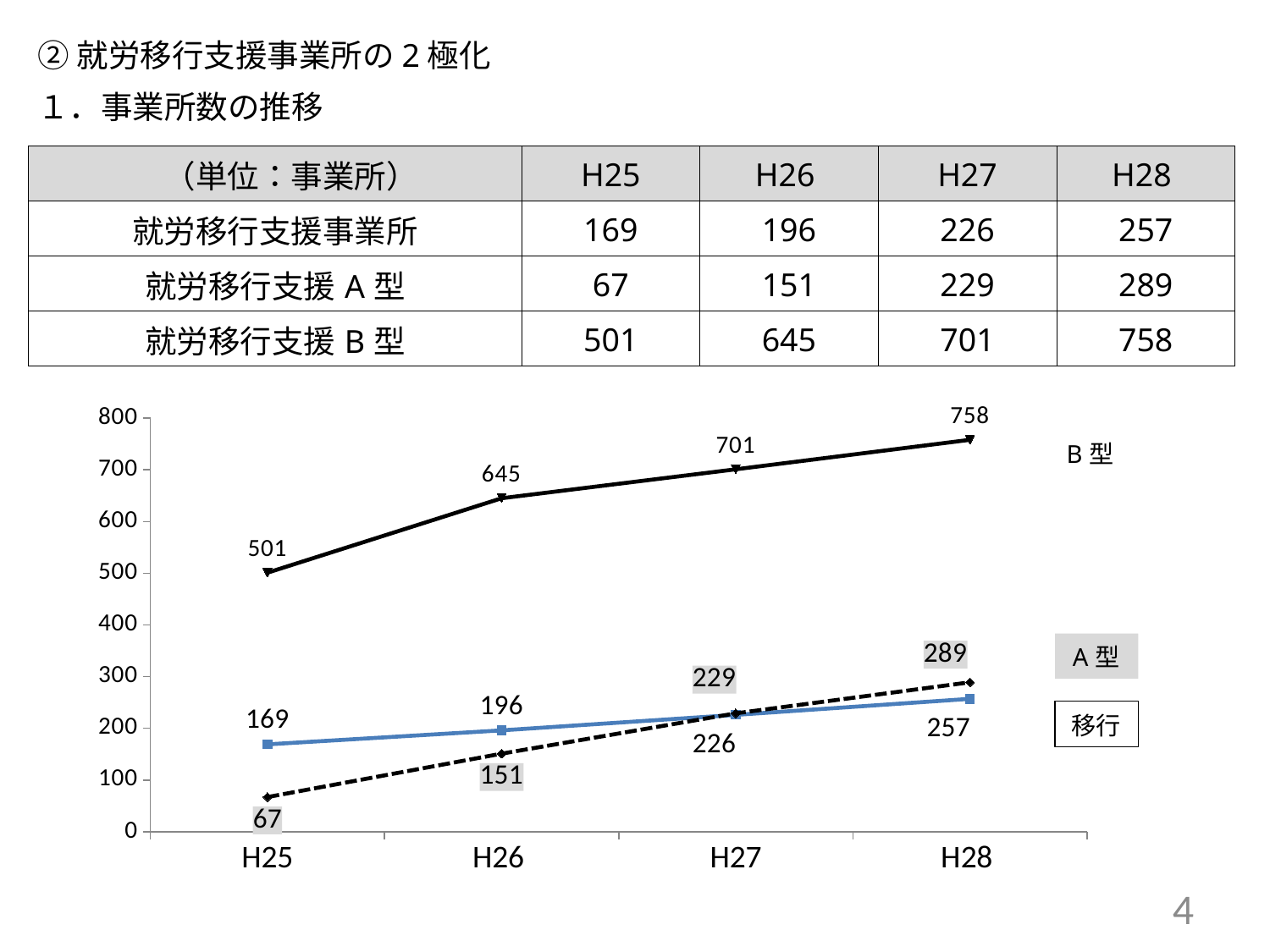
What is the value for A型 in H25? 67 What is the value for B型 in H28? 758 Does the A型 series rise or fall from H25 to H28? rise In which year is the A型 series highest? H28 How many series are plotted in the chart? 3 Which is larger in H26, the 移行 value or the A型 value? 移行 What is the value for 移行 in H27? 226 How many years are shown on the x axis? 4 What type of chart is shown on the slide? line chart What is the difference between the A型 value and the 移行 value in H28? 32 In which year is the B型 series lowest? H25 What is the difference between the B型 value in H28 and the B型 value in H25? 257